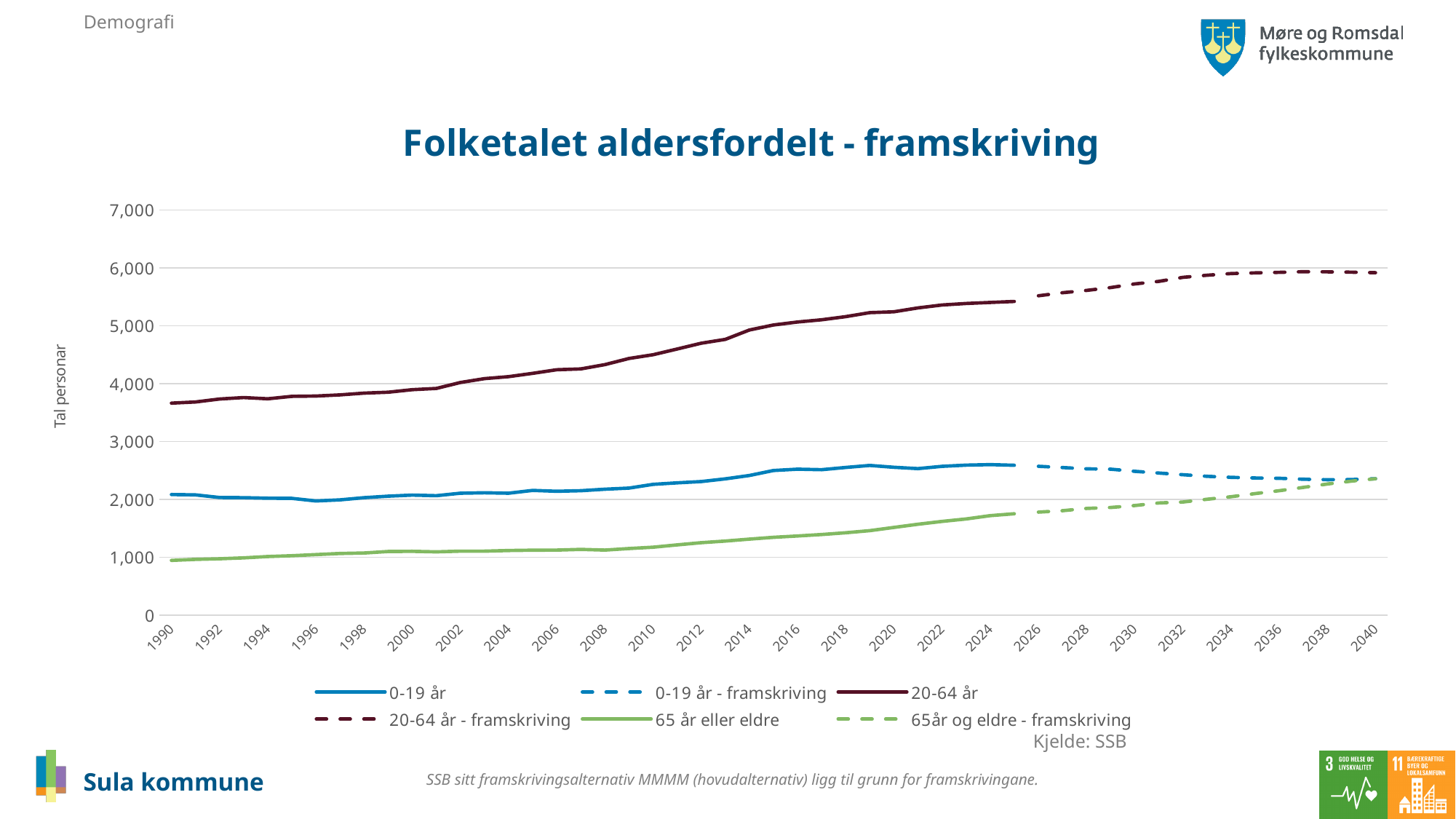
Which age group series has the highest values across the whole chart? 20-64 år Does the 65 år eller eldre series rise or fall from 1990 to 2024? rise What is the title of the chart? Folketalet aldersfordelt - framskriving How many series does the legend list? 6 Does the 0-19 år - framskriving series rise or fall from 2026 to 2040? fall What source is cited below the chart legend? Kjelde: SSB What kind of chart is shown on the slide? line chart Is the value for 20-64 år - framskriving in 2040 greater or less than 5,000? greater In 2024, which is larger: the value for 0-19 år or the value for 65 år eller eldre? 0-19 år Is the value for 20-64 år in 2024 greater or less than 5,000? greater Is the value for 0-19 år in 2024 greater or less than 3,000? less